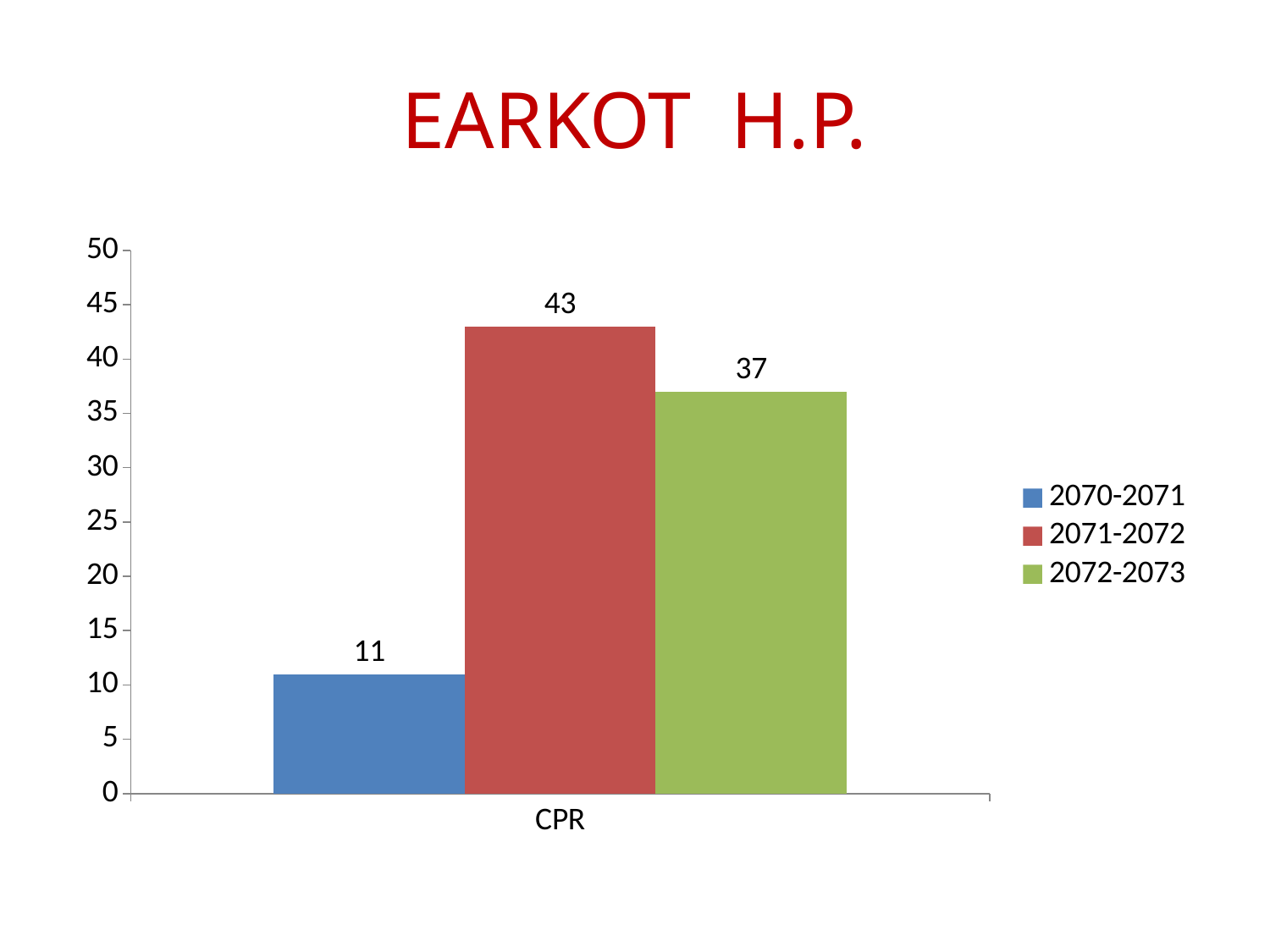
What is the title of the slide? EARKOT H.P. What is the CPR value for 2071-2072? 43 What kind of chart is shown on the slide? bar chart How many series does the legend list? 3 What is the difference between the CPR values for 2071-2072 and 2070-2071? 32 Which series has the highest CPR value? 2071-2072 What is the difference between the CPR values for 2071-2072 and 2072-2073? 6 Is the CPR value for 2072-2073 greater or less than 40? less Which is larger, the CPR value for 2070-2071 or for 2072-2073? 2072-2073 Which series has the lowest CPR value? 2070-2071 What is the CPR value for 2072-2073? 37 What is the CPR value for 2070-2071? 11